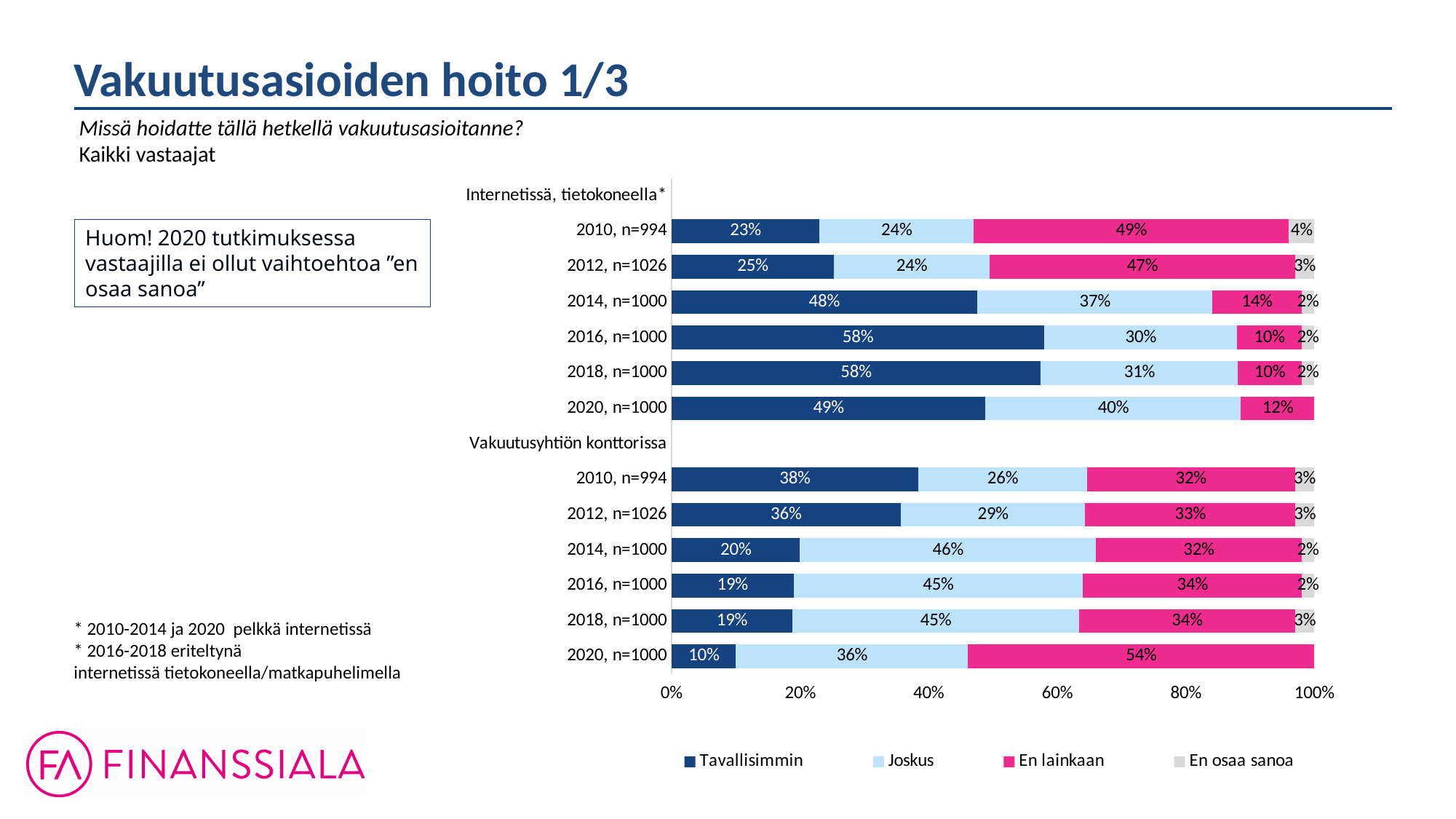
Within the 'Internetissä, tietokoneella' group, which year has the highest 'En lainkaan' value? 2010, n=994 What type of chart is shown on the slide? stacked bar chart How many series does the legend list? 4 What is the 'En lainkaan' value for 'Vakuutusyhtiön konttorissa' in 2020, n=1000? 54% What is the 'Joskus' value for 'Vakuutusyhtiön konttorissa' in 2014, n=1000? 46% What is the difference between the 'Tavallisimmin' value for 'Internetissä, tietokoneella' in 2018, n=1000 and in 2010, n=994? 35 percentage points Does the 'Tavallisimmin' value for 'Internetissä, tietokoneella' rise or fall from 2010 to 2016? rise Which legend entry is shown in pink? En lainkaan Within the 'Vakuutusyhtiön konttorissa' group, which year has the lowest 'Tavallisimmin' value? 2020, n=1000 What is the 'Tavallisimmin' value for 'Internetissä, tietokoneella' in 2020, n=1000? 49% How many year bars are shown in the 'Vakuutusyhtiön konttorissa' group? 6 Which is larger: the 'Joskus' value for 'Internetissä, tietokoneella' in 2020, n=1000 or the 'Joskus' value for 'Vakuutusyhtiön konttorissa' in 2020, n=1000? Internetissä, tietokoneella 2020, n=1000